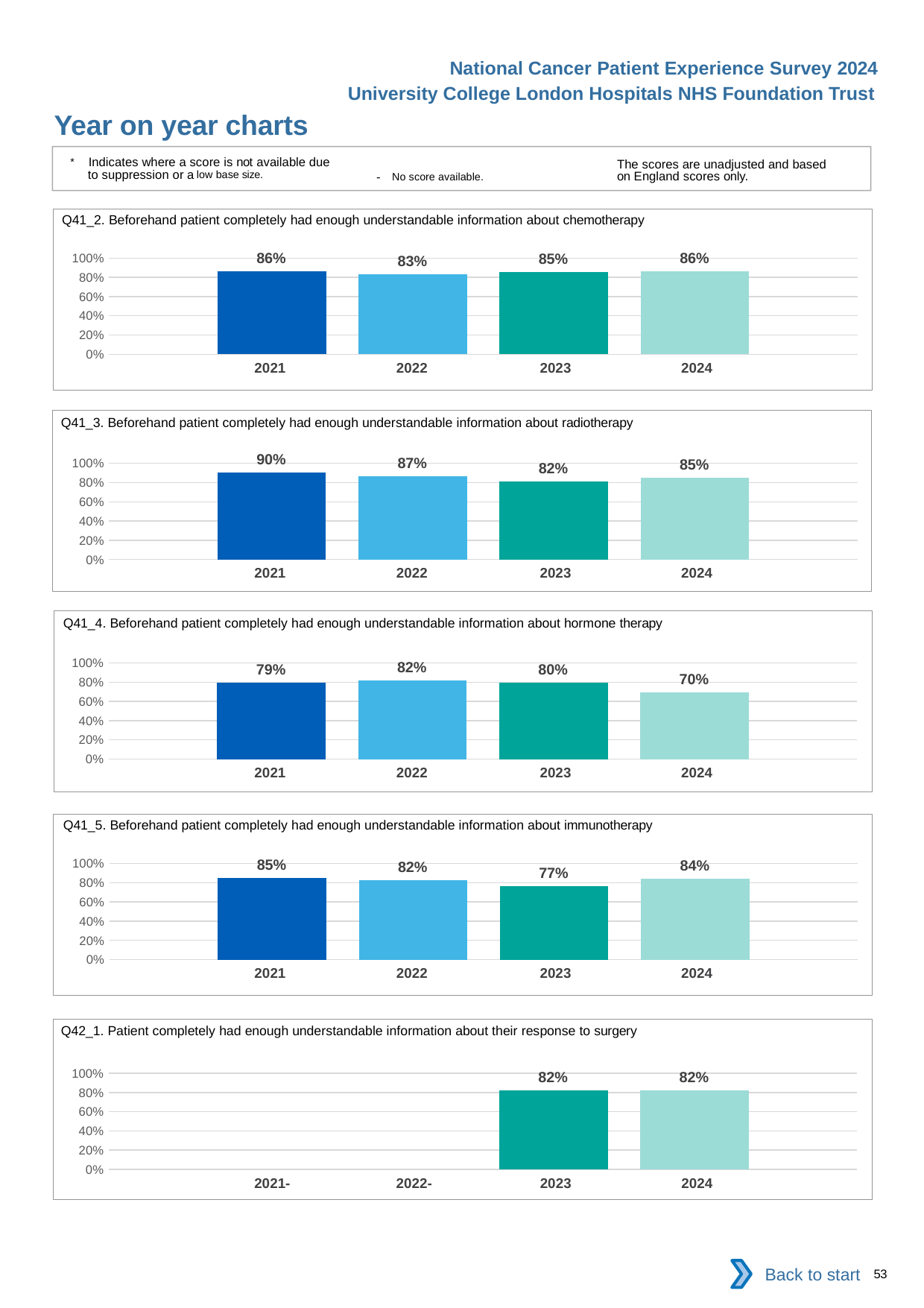
In the Q41_4 chart (hormone therapy), what is the value for 2022? 82% In the Q41_3 chart (radiotherapy), which year has the highest value? 2021 In the Q41_3 chart (radiotherapy), do the values rise or fall from 2021 to 2023? Fall In the Q42_1 chart (response to surgery), what is the value for 2023? 82% In the Q41_5 chart (immunotherapy), which is larger, the value for 2021 or the value for 2023? 2021 In the Q41_2 chart (chemotherapy), what is the value for 2022? 83% In the Q41_5 chart (immunotherapy), what is the value for 2024? 84% In the Q41_4 chart (hormone therapy), which year has the lowest value? 2024 In the Q42_1 chart (response to surgery), how many years have a bar plotted? 2 In the Q41_3 chart (radiotherapy), what is the difference between the 2021 and 2023 values? 8% In the Q41_4 chart (hormone therapy), is the value for 2024 greater or less than 80%? less What kind of chart is the Q41_2 chart (chemotherapy)? Bar chart